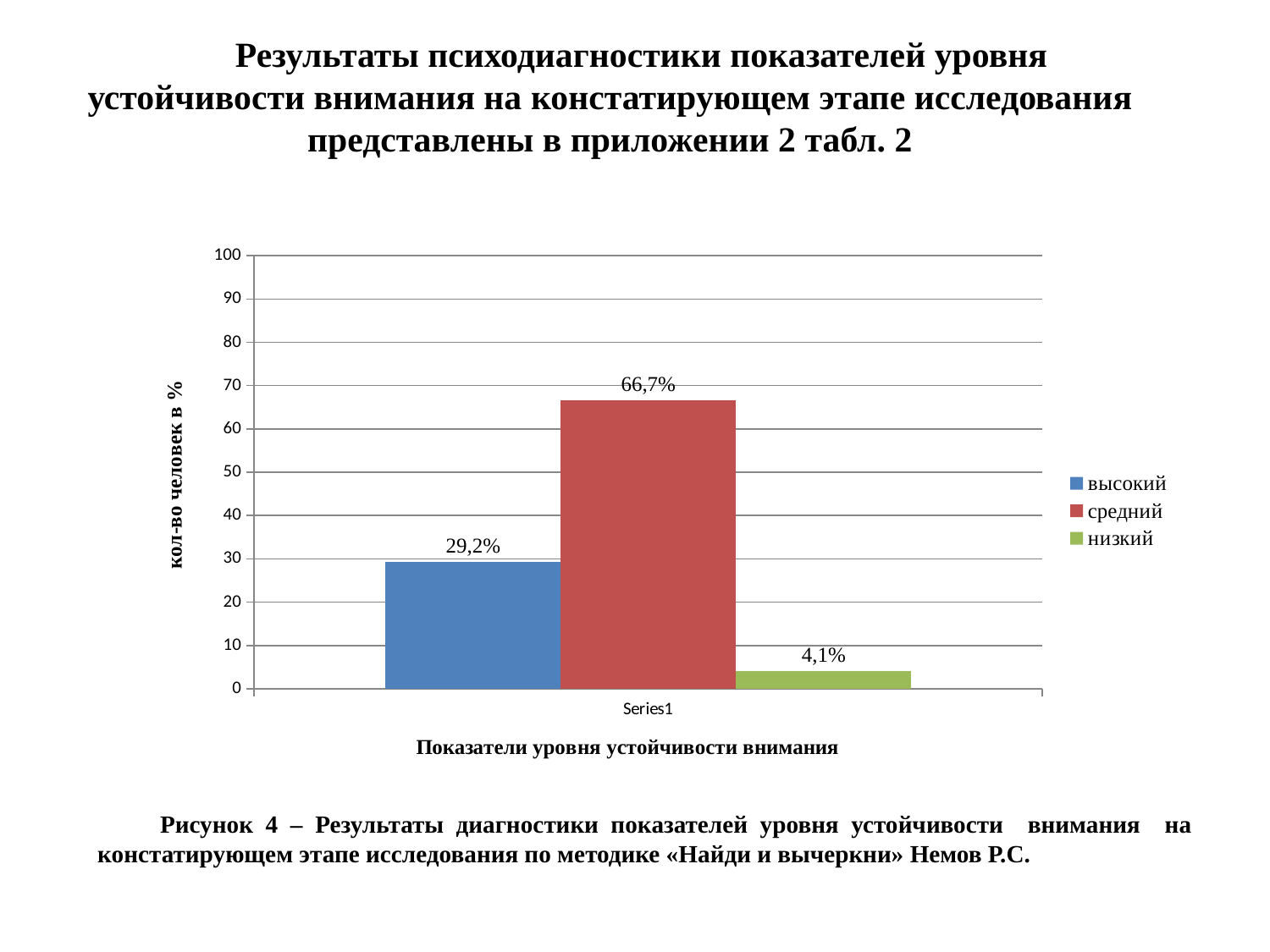
What is the difference between the values for "средний" and "высокий"? 37,5% What is the label of the vertical axis? кол-во человек в % Is the value for "средний" greater or less than 60? greater How many series does the legend list? 3 What kind of chart is shown on the slide? bar chart What is the difference between the values for "высокий" and "низкий"? 25,1% What is the value for the series "низкий"? 4,1% What is the value for the series "высокий"? 29,2% What is the value for the series "средний"? 66,7% Which series has the lowest value? низкий Which is larger, the value for "высокий" or the value for "низкий"? высокий Which series has the highest value? средний